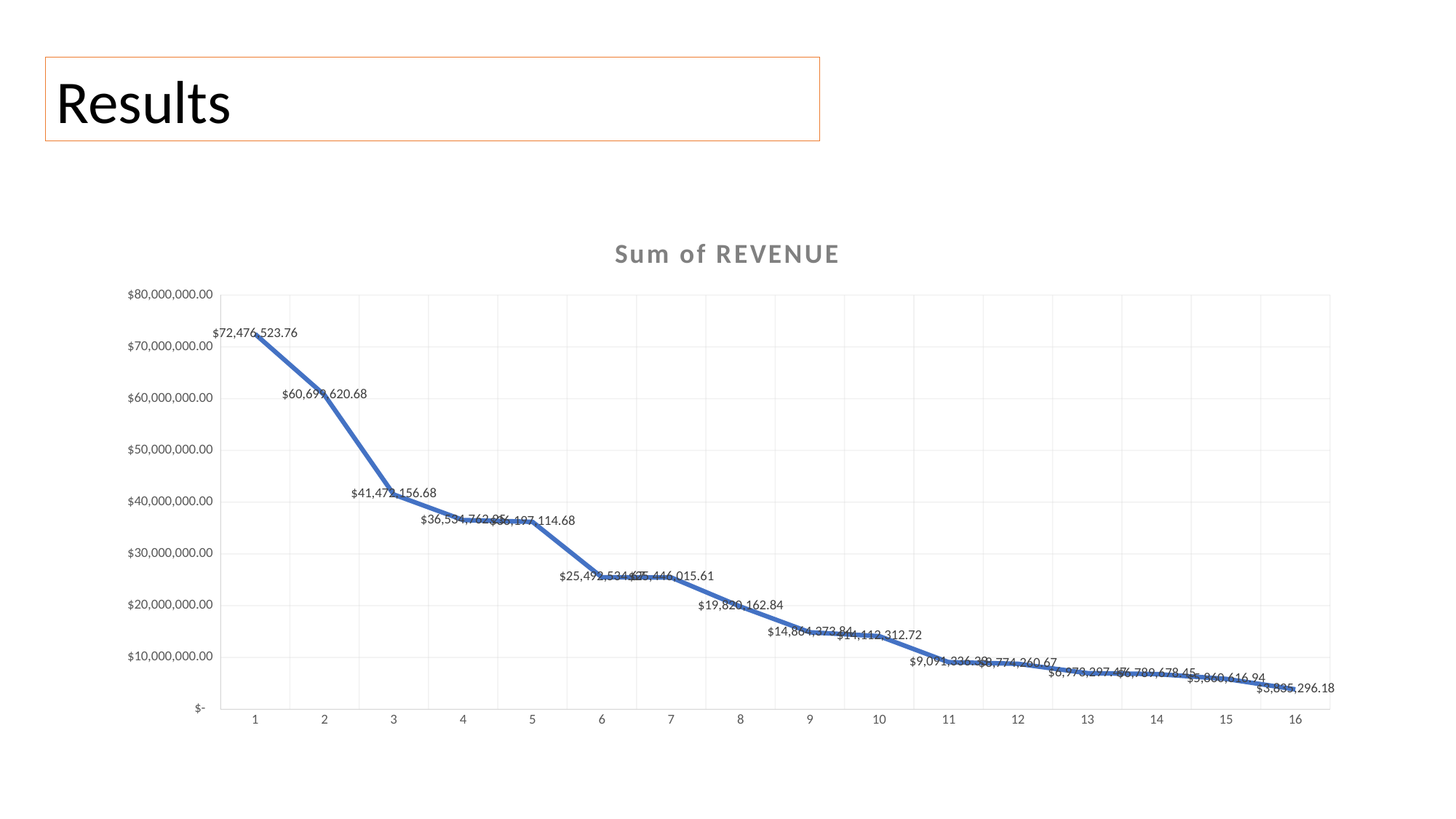
How many points are plotted along the x axis? 16 What is the Sum of REVENUE value at point 1? $72,476,523.76 What is the title of the chart? Sum of REVENUE What is the Sum of REVENUE value at point 2? $60,699,620.68 Which point has the lowest Sum of REVENUE? 16 What is the difference between the values at point 1 and point 2? $11,776,903.08 Is the value at point 4 greater or less than $30,000,000.00? greater What is the Sum of REVENUE value at point 8? $19,820,162.84 Do the values rise or fall from point 1 to point 16? fall What is the Sum of REVENUE value at point 3? $41,472,156.68 Which point has the highest Sum of REVENUE? 1 What type of chart is shown on the slide? line chart